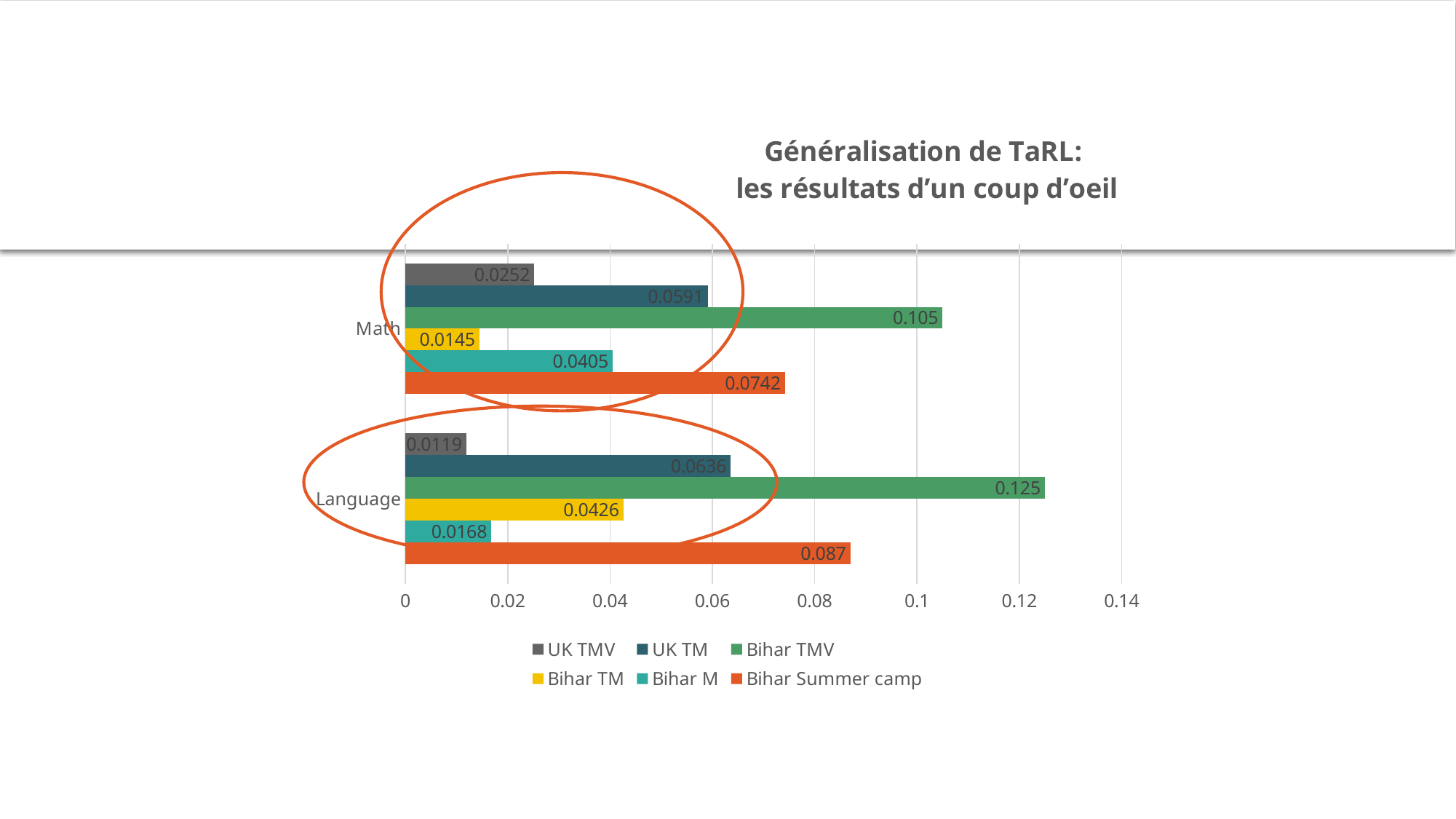
How many series does the legend list? 6 What is the value for Bihar TMV in the Math category? 0.105 What kind of chart is shown on the slide? Bar chart How many categories are shown on the vertical axis? 2 What is the value for Bihar Summer camp in the Language category? 0.087 What is the title of the chart? Généralisation de TaRL: les résultats d'un coup d'oeil Which series has the lowest value in the Math category? Bihar TM Which is larger: the Bihar M value for Math or the Bihar M value for Language? Math What is the difference between the Bihar TMV values for Language and Math? 0.02 Which series has the highest value in the Language category? Bihar TMV What is the value for Bihar TM in the Math category? 0.0145 What is the value for UK TM in the Language category? 0.0636